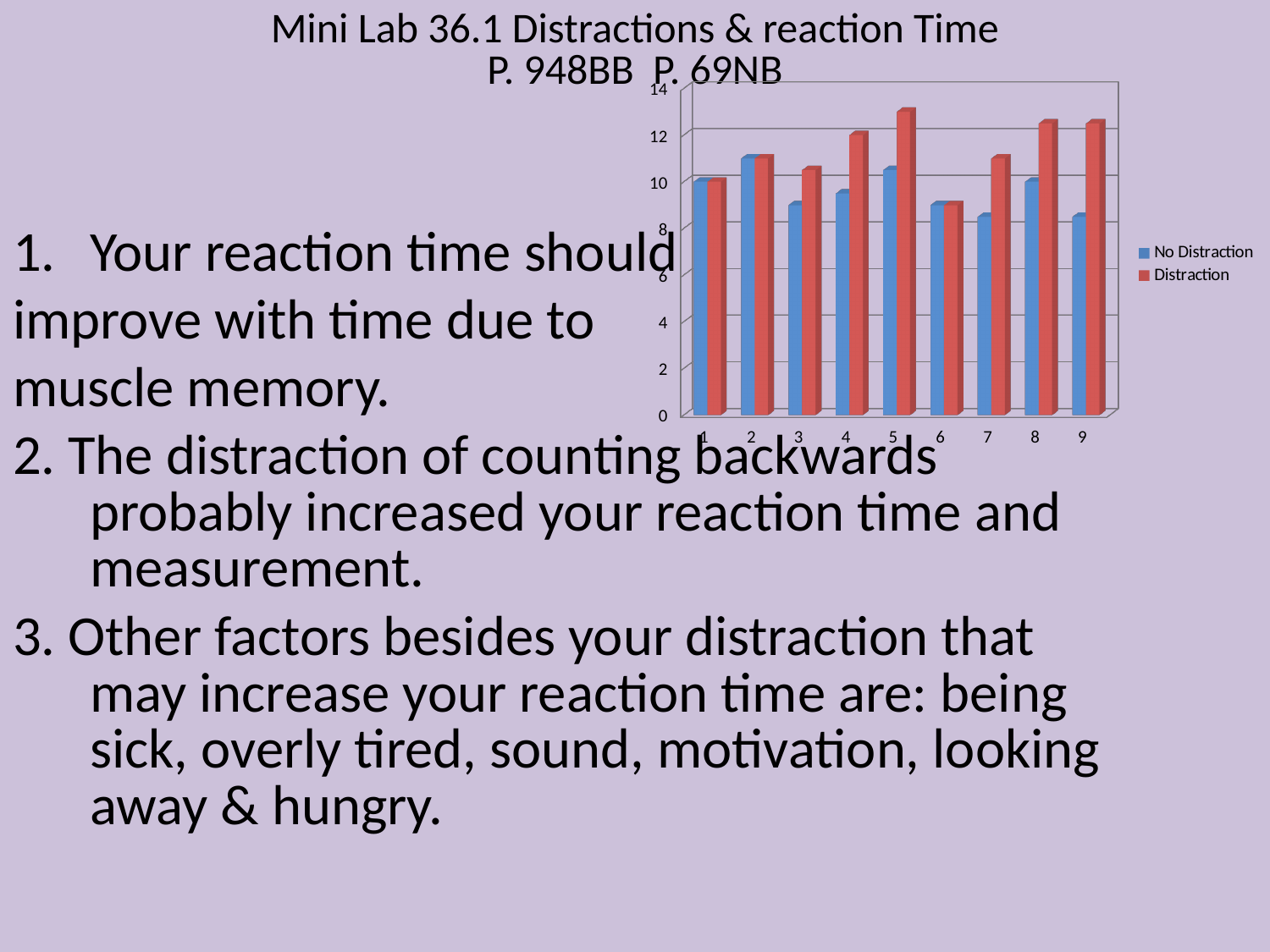
How many categories are shown along the x axis of the chart? 9 Is the No Distraction value for category 7 greater or less than 10? less For category 9, which series has the larger value, No Distraction or Distraction? Distraction Is the Distraction value for category 5 greater or less than 12? greater For category 4, which series has the larger value, No Distraction or Distraction? Distraction What kind of chart is shown on the slide? Bar chart Which colour represents the Distraction series in the chart? Red For which category is the Distraction value highest? 5 How many series does the chart legend list? 2 For which category is the Distraction value lowest? 6 What are the two series named in the chart legend? No Distraction and Distraction Is the Distraction value for category 4 greater or less than 10? greater